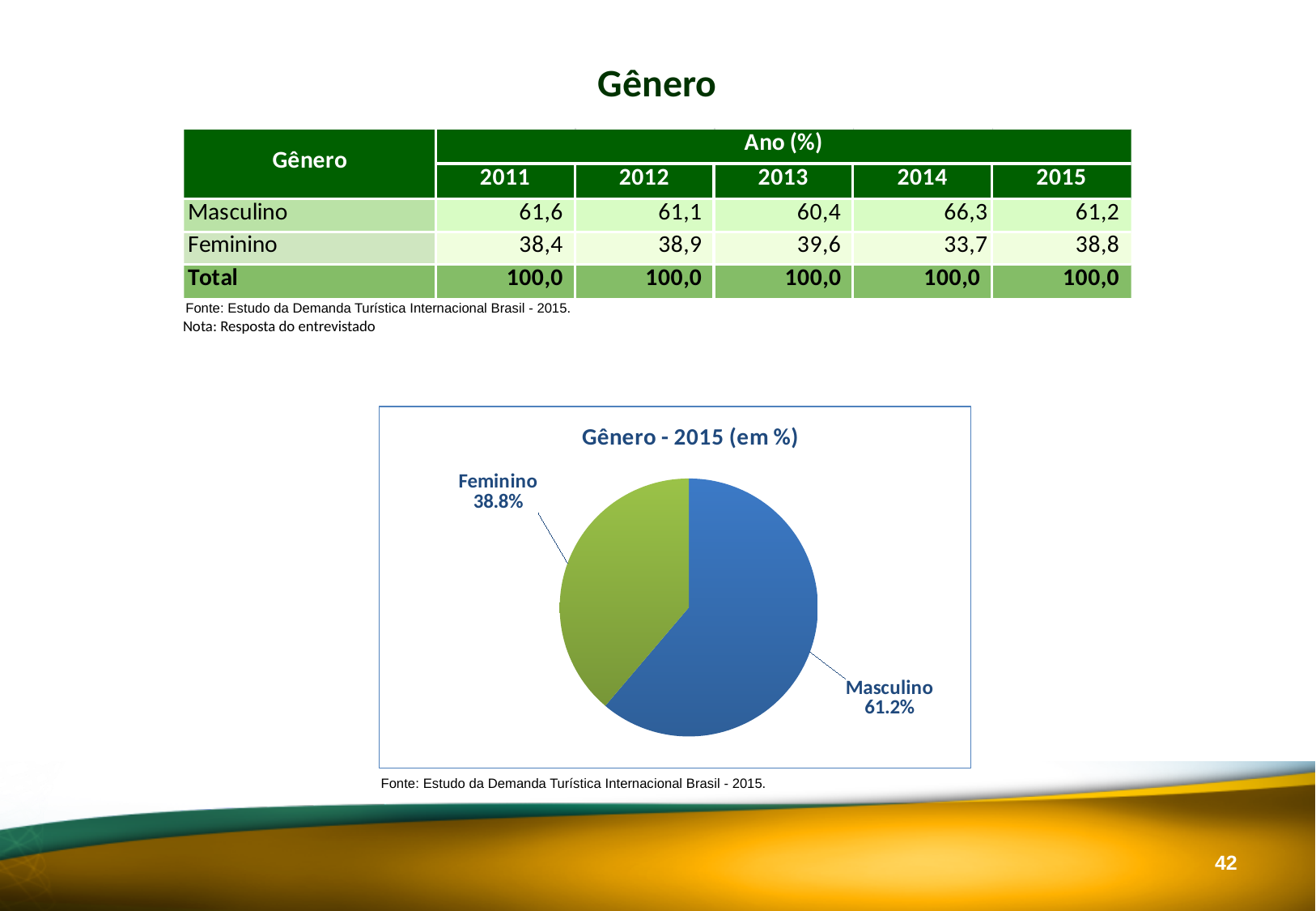
Which is larger in the pie chart, Masculino or Feminino? Masculino What is the difference between the Masculino and Feminino values in the pie chart? 22.4% Which slice of the pie chart is the largest? Masculino How many slices does the pie chart have? 2 Which slice of the pie chart is the smallest? Feminino What kind of chart is shown on the slide? pie chart What share of the pie does the Feminino slice represent? 38.8% What is the value for Feminino in the pie chart? 38.8% What is the title of the chart? Gênero - 2015 (em %) What colour is the Masculino slice in the pie chart? blue What is the value for Masculino in the pie chart? 61.2%